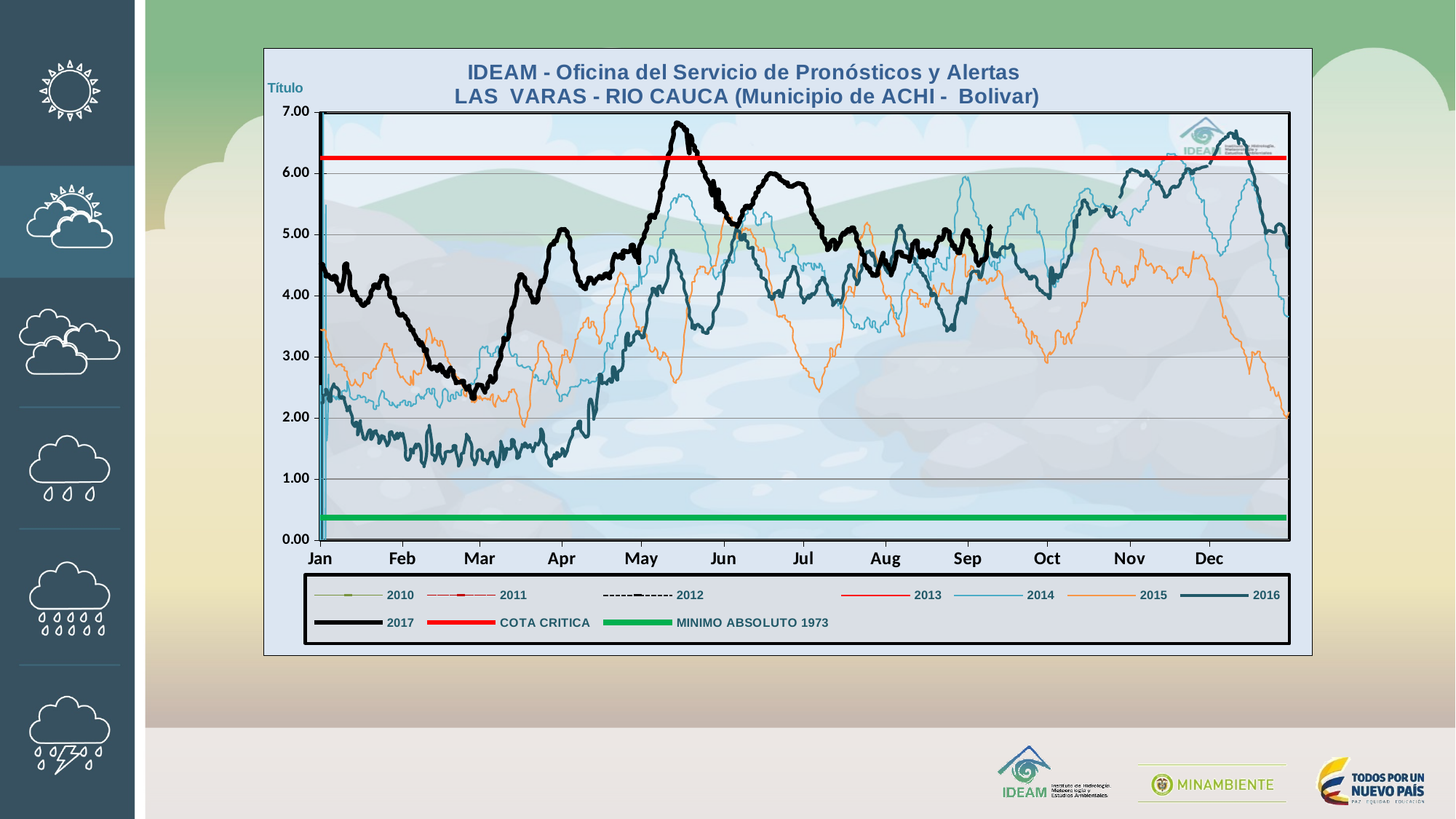
Is the value of the 2016 series in February greater or less than 2.00? less Which series has the larger value in February, 2017 or 2016? 2017 Is the peak value of the 2017 series in late May greater or less than 6.00? greater Does the 2016 series rise or fall from January to February? fall What kind of chart is shown on the slide? line chart Is the value of the 2015 series at the start of January greater or less than 3.00? greater How many month labels are shown along the x axis? 12 Does the 2017 series rise or fall from April to late May? rise What colour is the COTA CRITICA line? red How many series does the legend list? 10